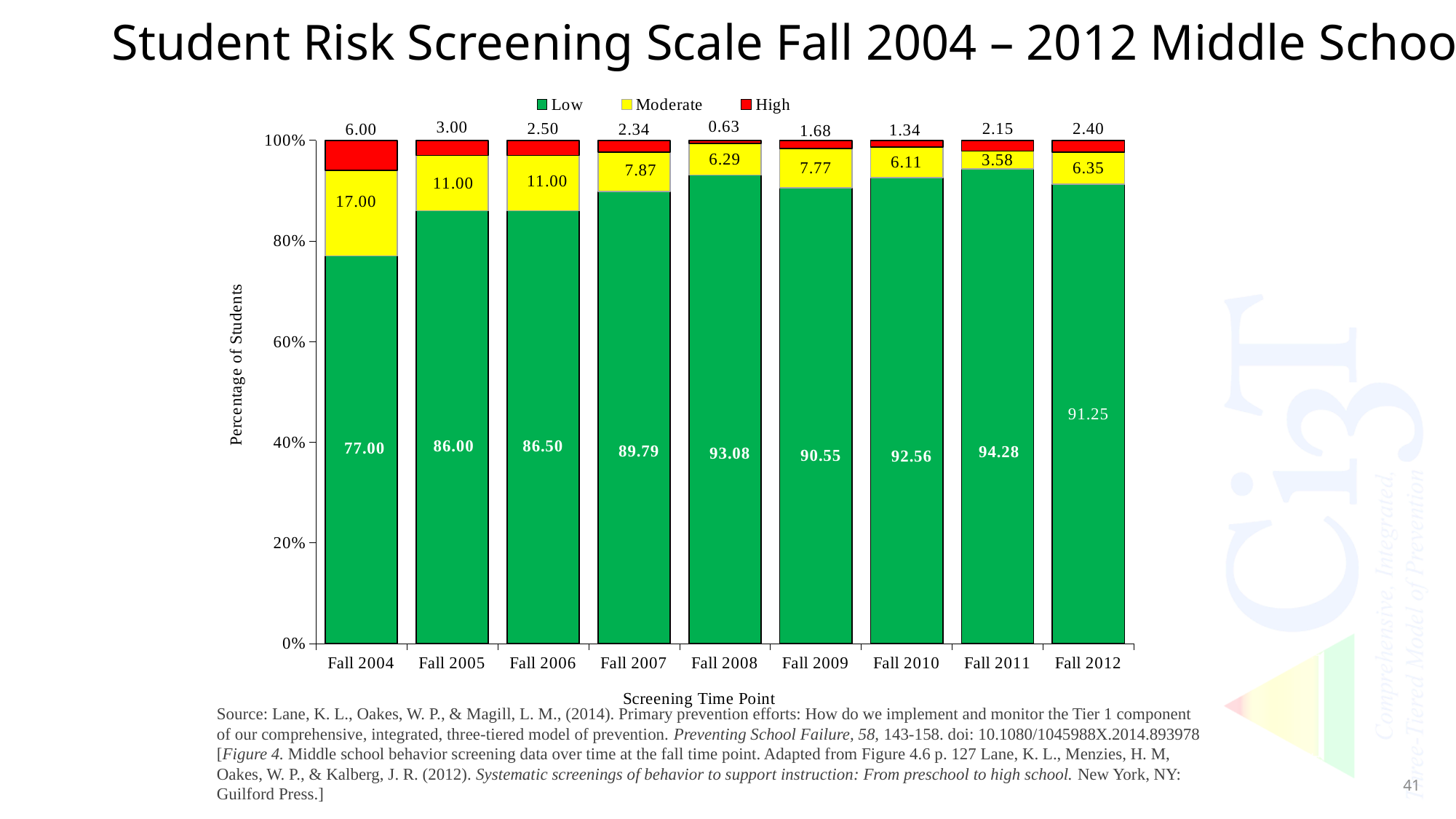
What kind of chart is shown on the slide? Stacked bar chart Which screening time point has the lowest High value? Fall 2008 Does the Low value generally rise or fall from Fall 2004 to Fall 2012? Rise Which is larger, the High value for Fall 2005 or the High value for Fall 2012? Fall 2005 What is the High value for Fall 2008? 0.63 What is the Moderate value for Fall 2011? 3.58 Which screening time point has the highest Low value? Fall 2011 How many series does the legend list? 3 What percentage of students were in the Low category in Fall 2004? 77.00 How many screening time points are shown on the x axis? 9 What is the difference between the Low value in Fall 2012 and the Low value in Fall 2004? 14.25 Which screening time point has the highest Moderate value? Fall 2004